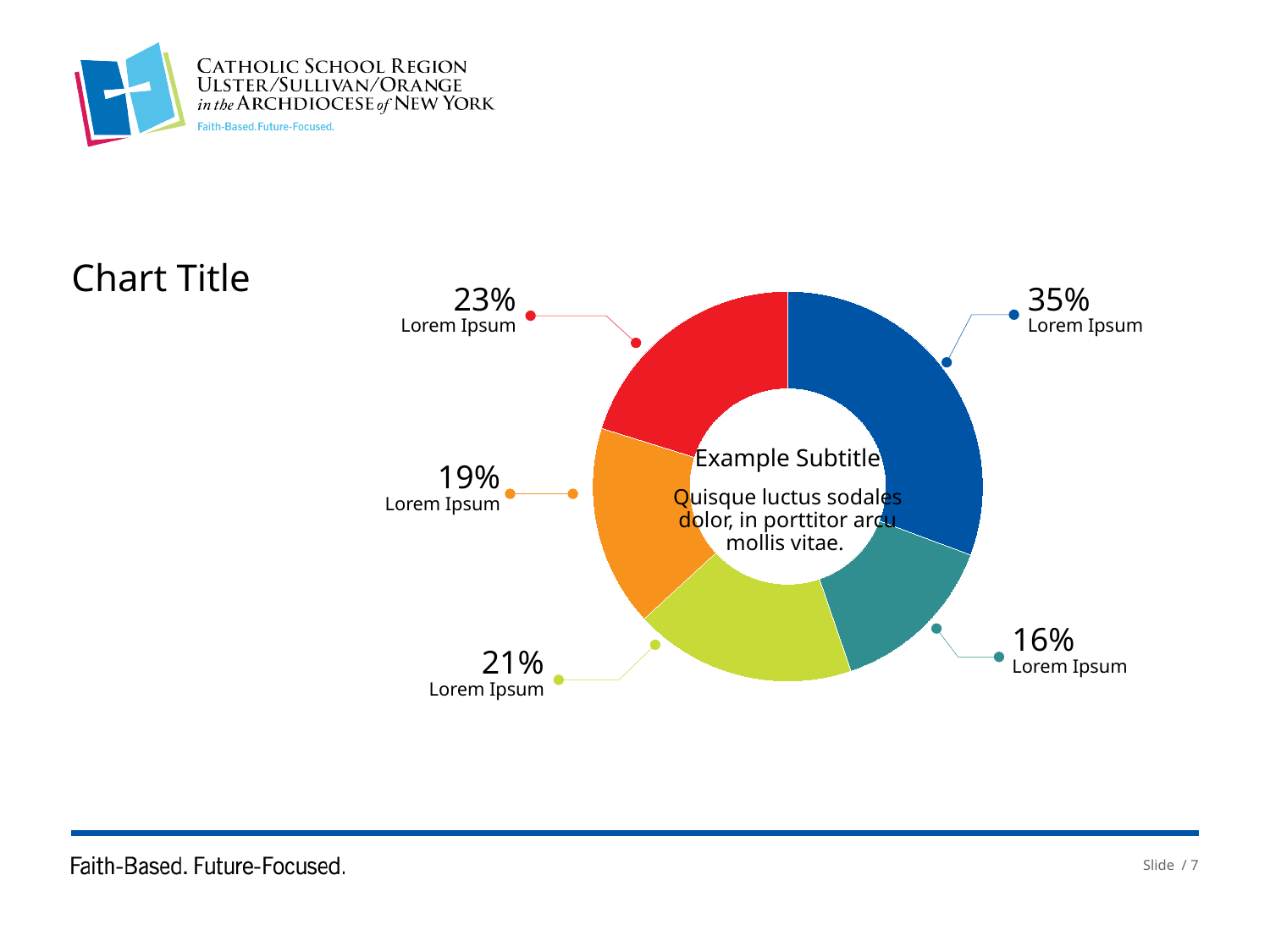
What percentage is shown for the orange slice? 19% Which slice has the largest percentage? The dark blue slice (35%) What percentage is shown for the dark blue slice? 35% Which is larger, the red slice or the yellow-green slice? The red slice (23%) What is the title of the chart? Chart Title How many slices does the pie chart have? 5 What percentage is shown for the teal slice? 16% What kind of chart is shown on the slide? Pie chart (donut) Which slice has the smallest percentage? The teal slice (16%) What text appears in the centre of the donut chart as its subtitle? Example Subtitle What percentage is shown for the red slice? 23% What is the difference between the largest slice (35%) and the smallest slice (16%)? 19 percentage points